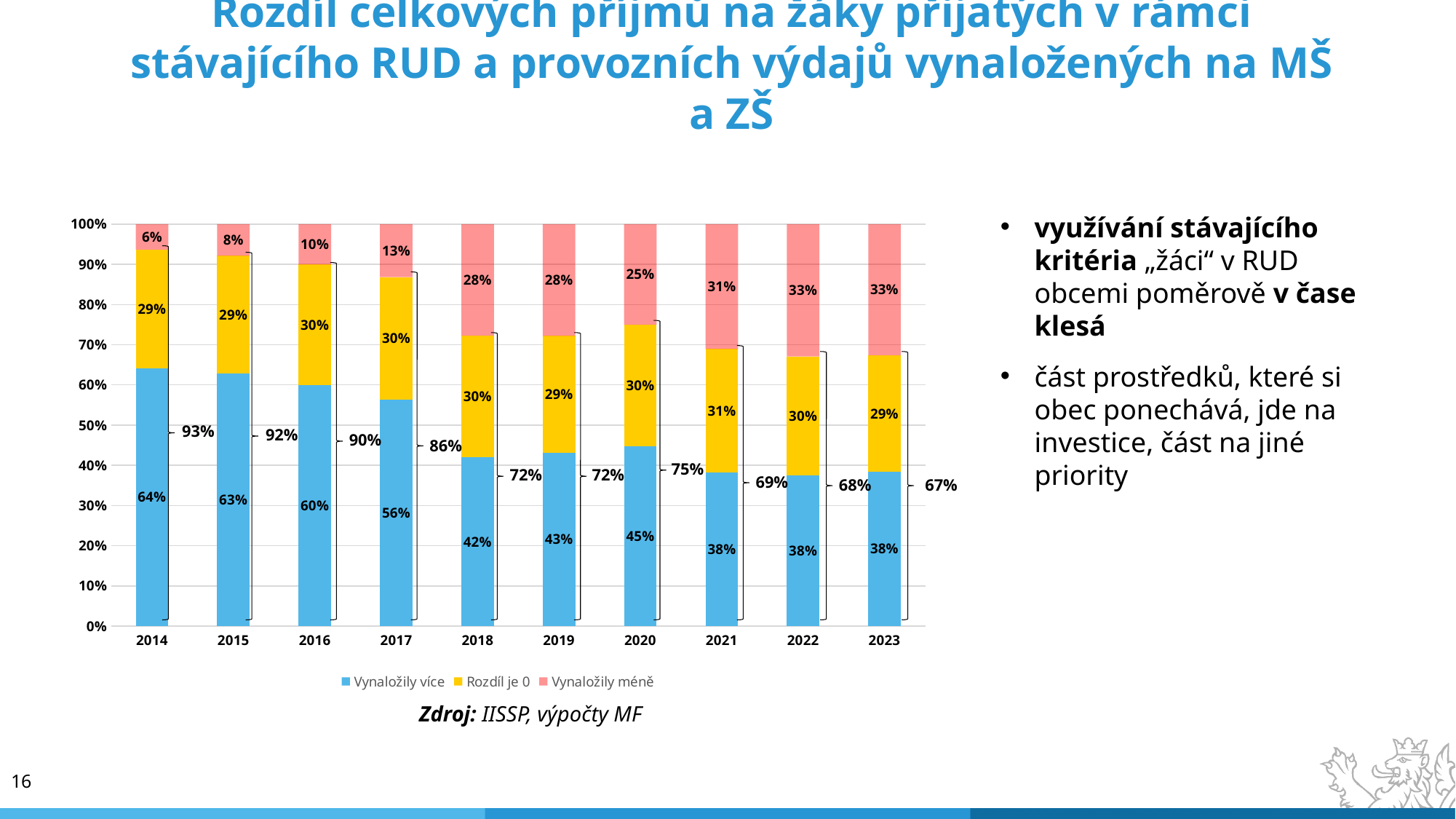
In which year is the 'Vynaložily více' share the highest? 2014 Does the 'Vynaložily více' share rise or fall from 2014 to 2023? fall How many years are shown on the x axis? 10 What is the value of 'Vynaložily méně' for 2023? 33% What is the value of 'Rozdíl je 0' for 2018? 30% In which year is the 'Vynaložily méně' share the lowest? 2014 How many series does the legend list? 3 What is the value of 'Vynaložily více' for 2014? 64% What type of chart is shown on the slide? stacked bar chart Which is larger: the 'Vynaložily méně' value for 2017 or for 2020? 2020 What is the combined share of 'Vynaložily více' and 'Rozdíl je 0' shown by the bracket for 2021? 69% What is the difference between the 'Vynaložily více' values for 2014 and 2023? 26 percentage points